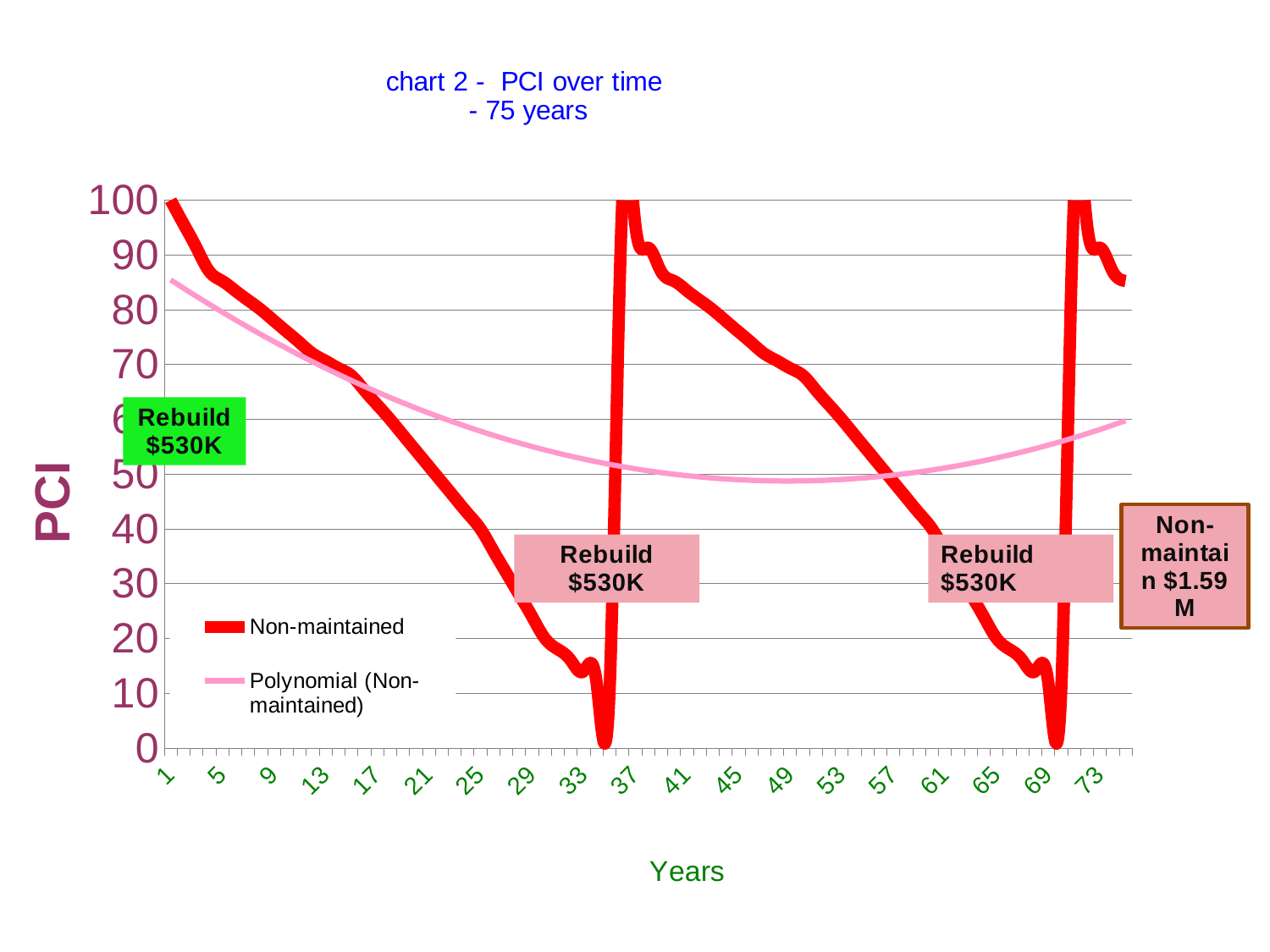
Is the Non-maintained value at year 65 greater or less than 30? less At year 25, which series has the higher value, Non-maintained or Polynomial (Non-maintained)? Polynomial (Non-maintained) What is the label on the vertical axis? PCI Is the Polynomial (Non-maintained) value at year 1 greater or less than 80? greater What kind of chart is shown on the slide? line chart Is the Non-maintained value at year 45 greater or less than 70? greater What is the title of the chart? chart 2 - PCI over time - 75 years How many series does the legend list? 2 What is the value of the Non-maintained series at year 1? 100 Does the Non-maintained series rise or fall between year 1 and year 33? fall